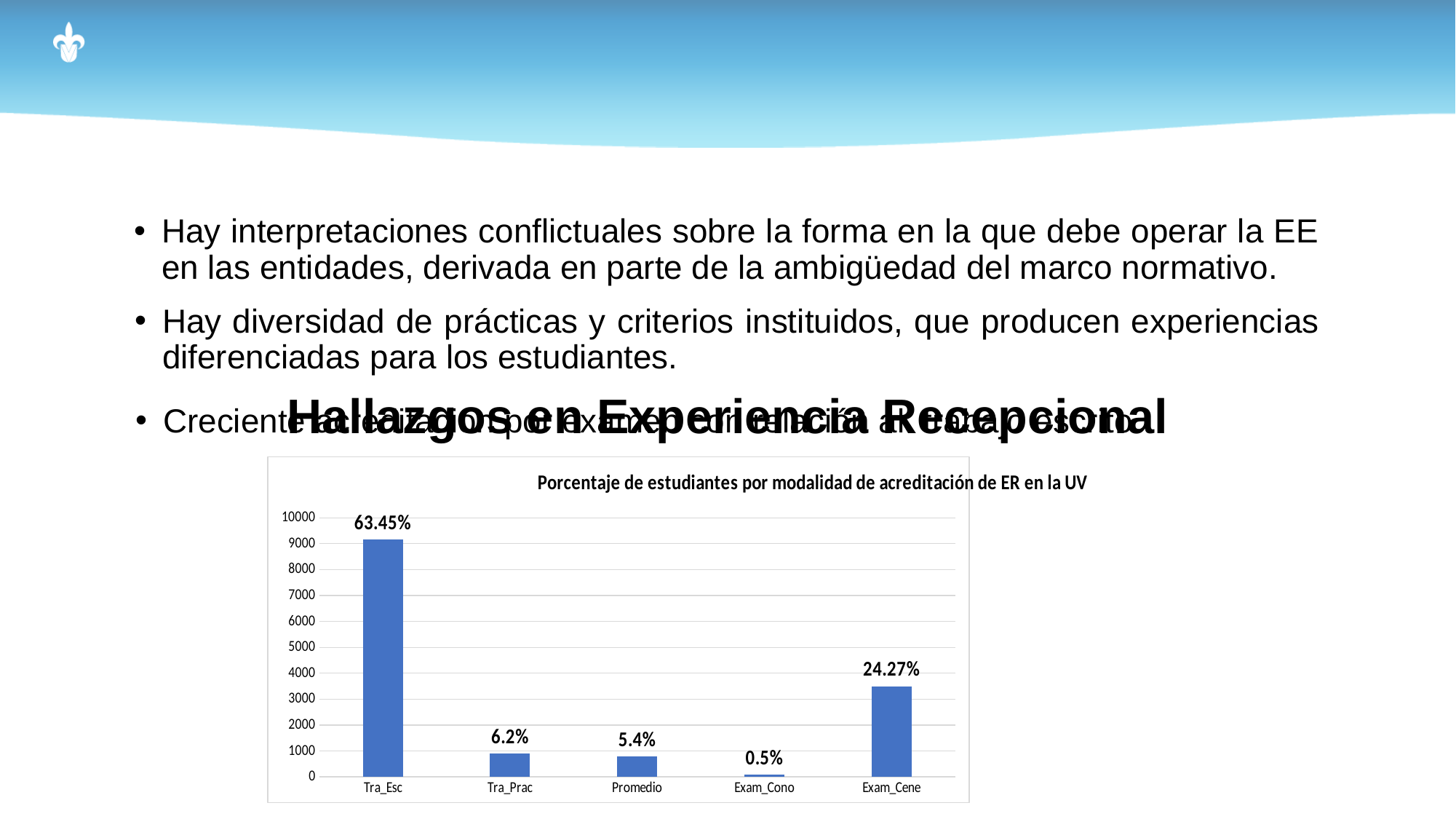
Which category has the highest value? Tra_Esc What is the data label shown for Tra_Esc? 63.45% What is the data label shown for Exam_Cene? 24.27% What is the title of the chart? Porcentaje de estudiantes por modalidad de acreditación de ER en la UV What is the difference between the percentage labels for Tra_Esc and Exam_Cene? 39.18% Which category has the lowest value? Exam_Cono Which is larger, the value for Tra_Prac or the value for Promedio? Tra_Prac What is the data label shown for Promedio? 5.4% Is the bar for Exam_Cene greater or less than 3000 on the vertical axis? greater What is the data label shown for Exam_Cono? 0.5% How many categories are shown on the x axis? 5 What is the data label shown for Tra_Prac? 6.2%